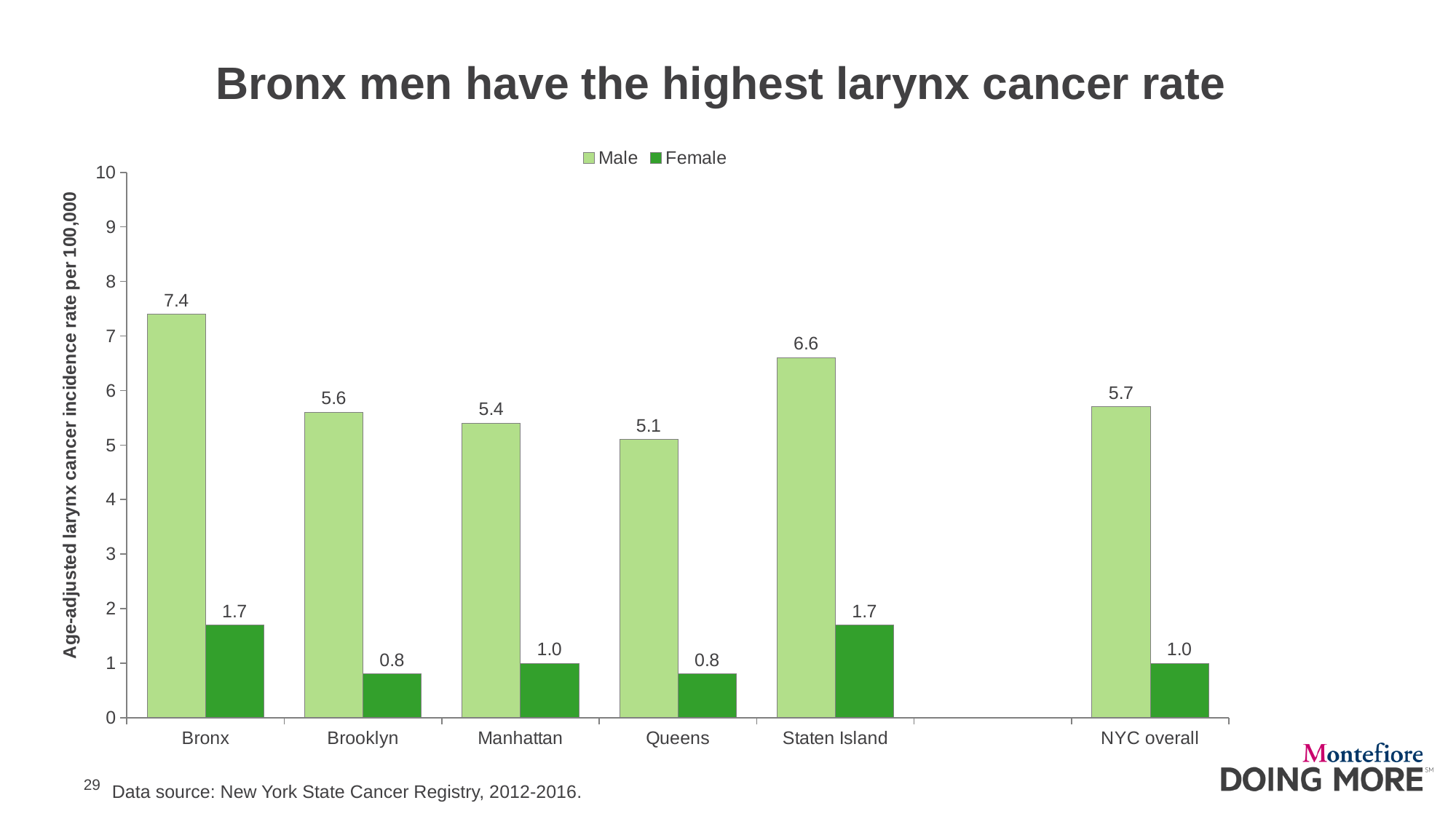
Which category has the lowest male larynx cancer incidence rate? Queens Which is larger, the male rate for Manhattan or the male rate for Queens? Manhattan What is the female larynx cancer incidence rate for Staten Island? 1.7 What is the difference between the male and female larynx cancer incidence rates in the Bronx? 5.7 What kind of chart is shown on the slide? Bar chart Which borough has the highest male larynx cancer incidence rate? Bronx What is the male larynx cancer incidence rate for NYC overall? 5.7 What is the difference between the male rates for Staten Island and Brooklyn? 1.0 Is the male rate for Staten Island greater or less than 6? greater What is the male larynx cancer incidence rate for the Bronx? 7.4 How many categories are shown on the x axis? 6 How many series does the legend list? 2